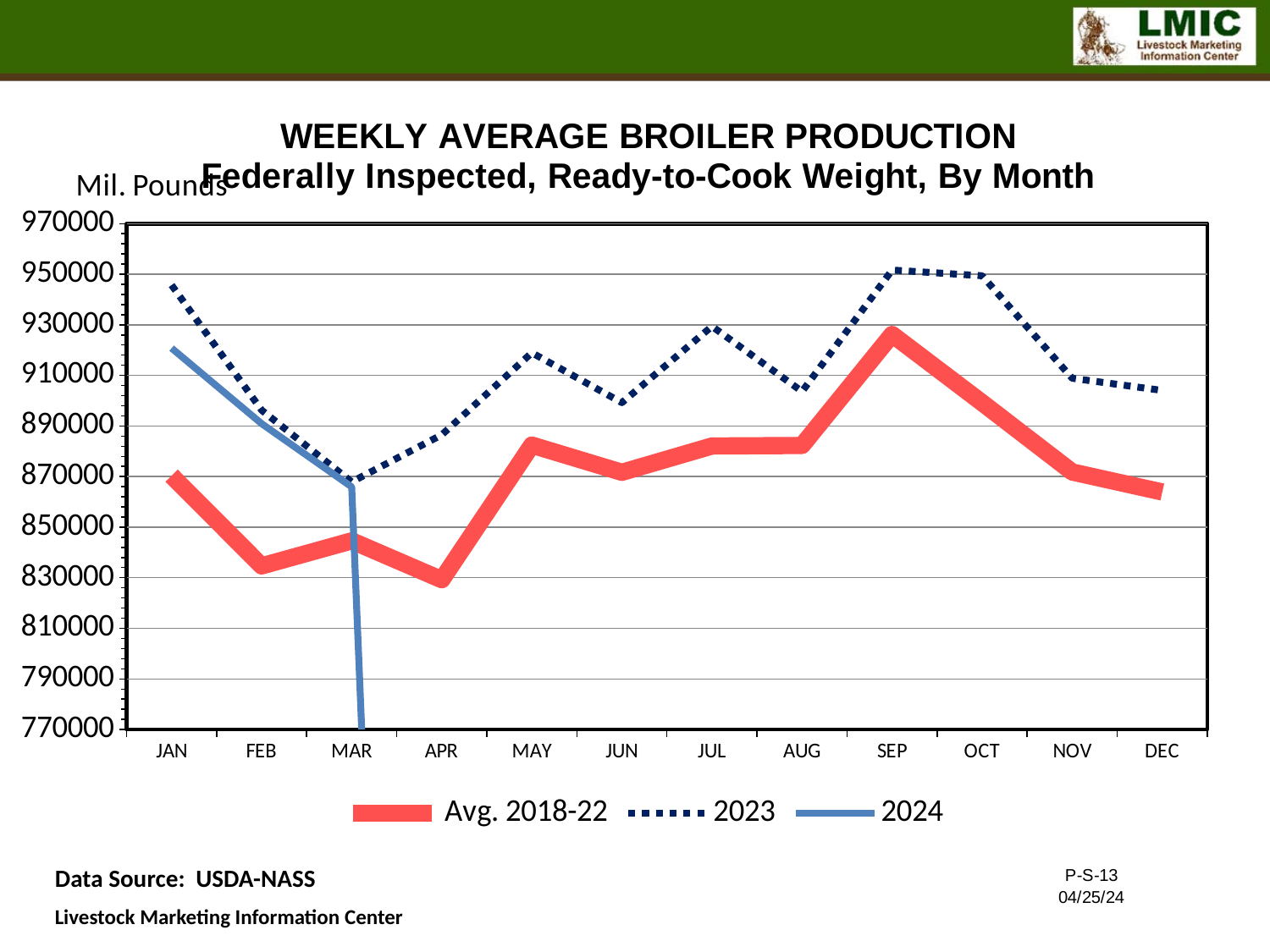
Is the value for 2024 in JAN greater or less than 910000? greater Does the Avg. 2018-22 series rise or fall from SEP to DEC? fall How many series does the legend list? 3 In JAN, which is larger: the 2023 value or the Avg. 2018-22 value? 2023 In JAN, which is larger: the 2023 value or the 2024 value? 2023 What kind of chart is shown on the slide? line chart What unit label is shown above the y axis? Mil. Pounds How many months are shown along the x axis? 12 Is the value for 2023 in JAN greater or less than 930000? greater Is the value for Avg. 2018-22 in APR greater or less than 850000? less In which month is the Avg. 2018-22 series at its highest? SEP In which month is the 2023 series at its lowest? MAR